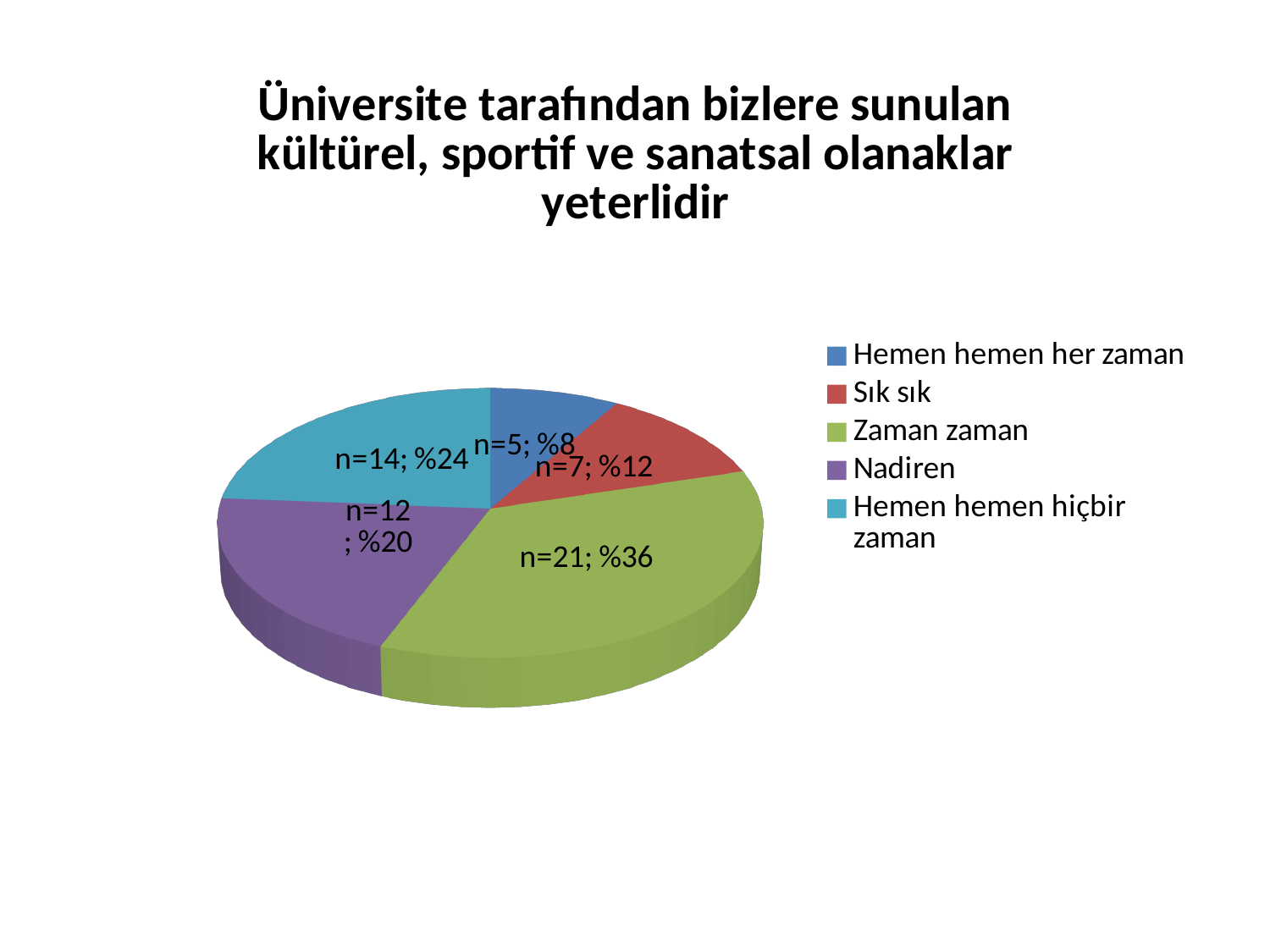
What kind of chart is shown on the slide? pie chart Which is larger, the "Nadiren" slice or the "Hemen hemen hiçbir zaman" slice? Hemen hemen hiçbir zaman What colour is the "Zaman zaman" slice? green What is the difference in n between "Zaman zaman" and "Sık sık"? 14 What percentage is shown for the "Hemen hemen her zaman" slice? %8 What percentage is shown for the "Nadiren" slice? %20 Which category has the largest slice? Zaman zaman How many slices does the pie chart have? 5 What is the n value for the "Zaman zaman" slice? n=21 What is the n value for the "Hemen hemen hiçbir zaman" slice? n=14 Which category has the smallest slice? Hemen hemen her zaman What share of the pie does the "Sık sık" slice represent? %12